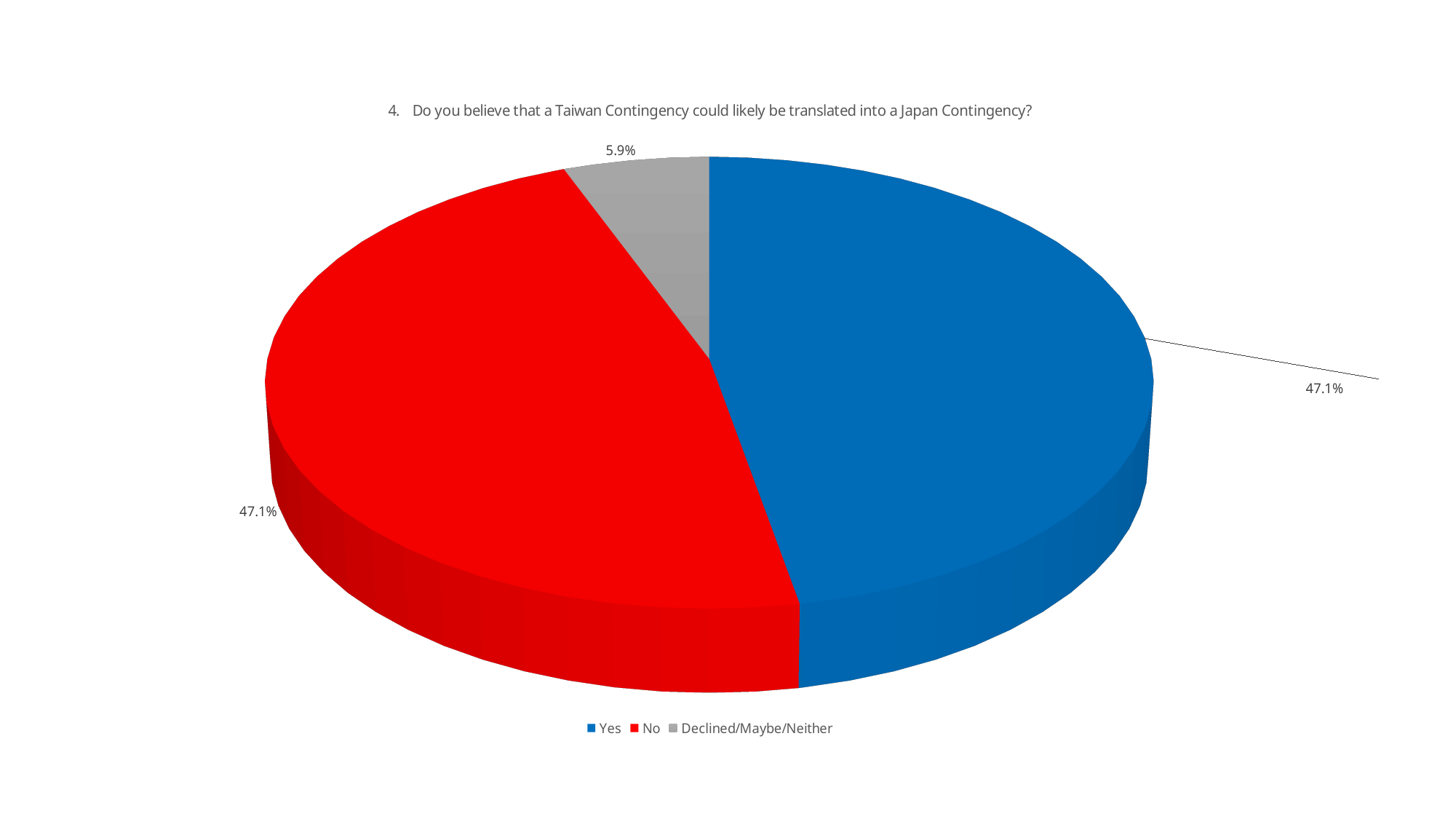
How many slices does the pie chart have? 3 What is the combined share of Yes and No? 94.2% What is the difference in percentage points between the Yes share and the Declined/Maybe/Neither share? 41.2 percentage points Which is larger, the share for No or the share for Declined/Maybe/Neither? No How many entries does the legend list? 3 What percentage of respondents answered No? 47.1% What question does the chart title ask? Do you believe that a Taiwan Contingency could likely be translated into a Japan Contingency? What percentage of respondents answered Yes? 47.1% What share of the pie is Declined/Maybe/Neither? 5.9% Which response has the smallest share of the pie? Declined/Maybe/Neither What kind of chart is shown on the slide? Pie chart What colour is the slice for No? Red